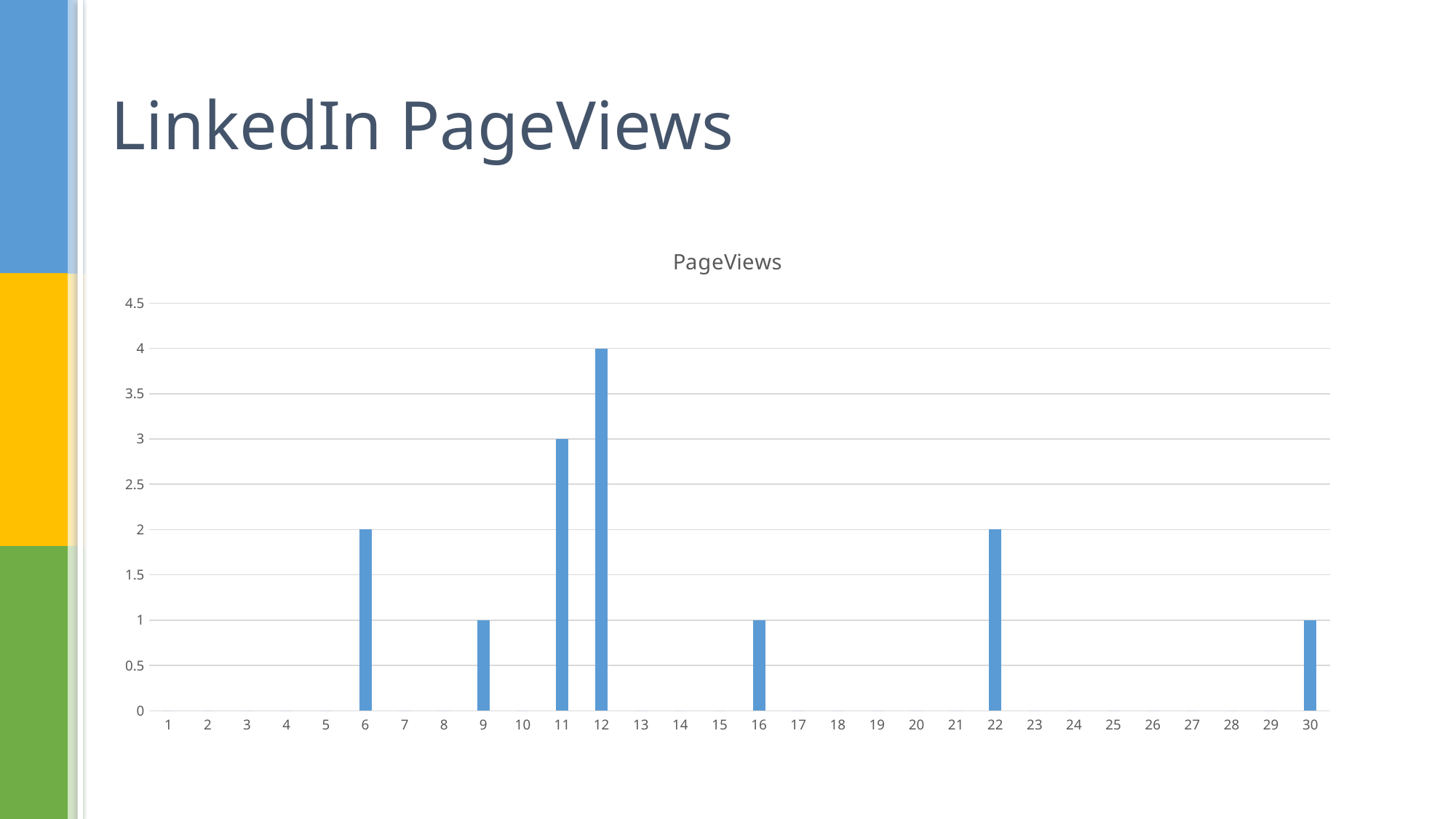
Which is larger, the value for category 11 or the value for category 22? 11 What is the value for category 11? 3 What is the difference between the values for category 6 and category 9? 1 Is the value for category 12 greater or less than 3.5? greater What kind of chart is shown? bar chart How many categories are shown on the x axis? 30 What is the difference between the values for category 12 and category 11? 1 What is the title of the chart? PageViews What is the value for category 12? 4 What is the value for category 6? 2 What is the value for category 22? 2 Which category has the highest value? 12